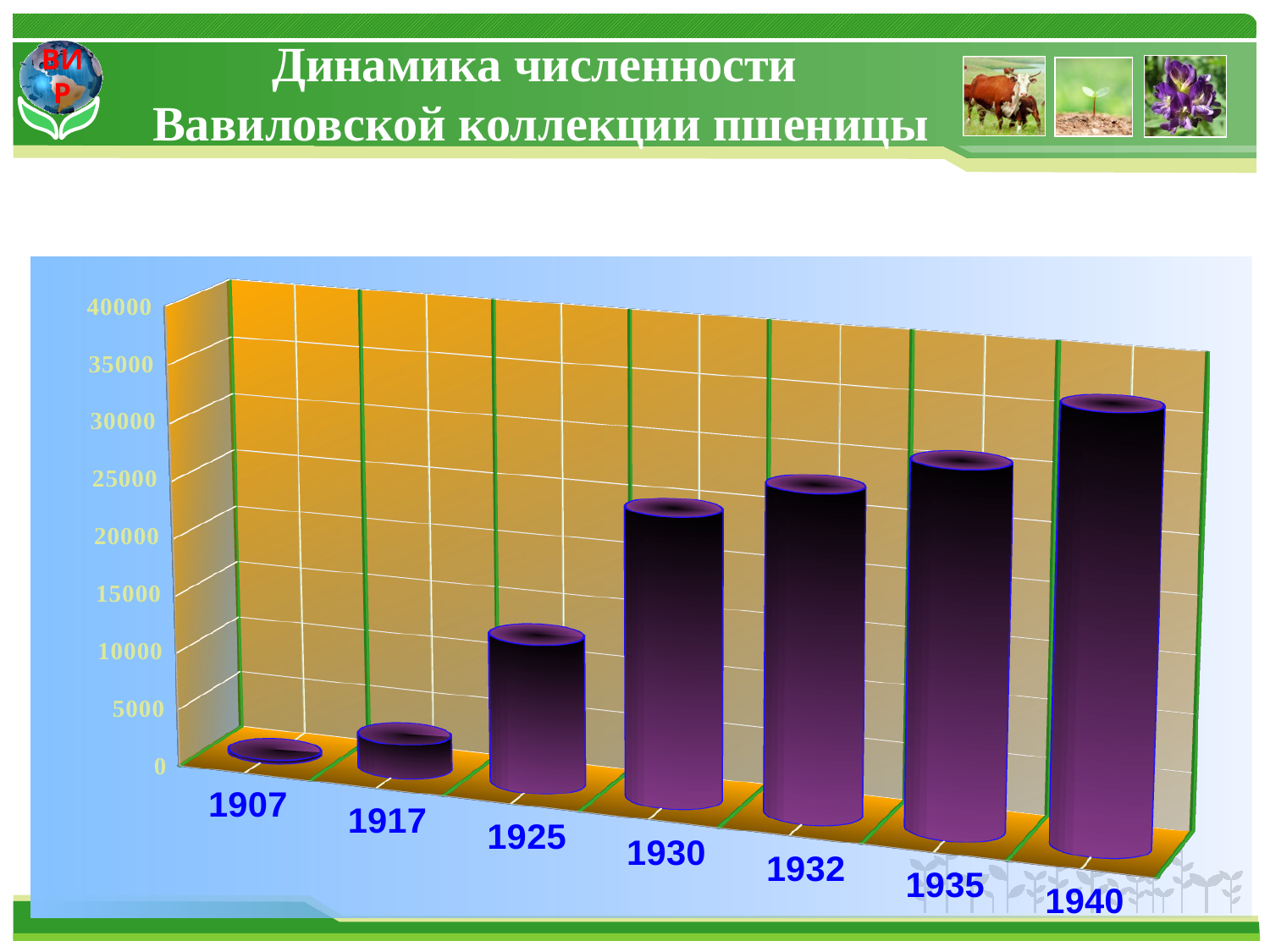
Which year has the highest value in the chart? 1940 Is the value for 1925 greater or less than 5000? greater Is the value for 1917 greater or less than 10000? less Which year has the lowest value in the chart? 1907 Is the value for 1930 greater or less than 15000? greater Which is larger, the value for 1930 or the value for 1917? 1930 What is the title of the slide containing the chart? Динамика численности Вавиловской коллекции пшеницы How many years are shown on the x axis of the chart? 7 Do the values rise or fall from 1907 to 1940? Rise What kind of chart is shown on the slide? Bar chart